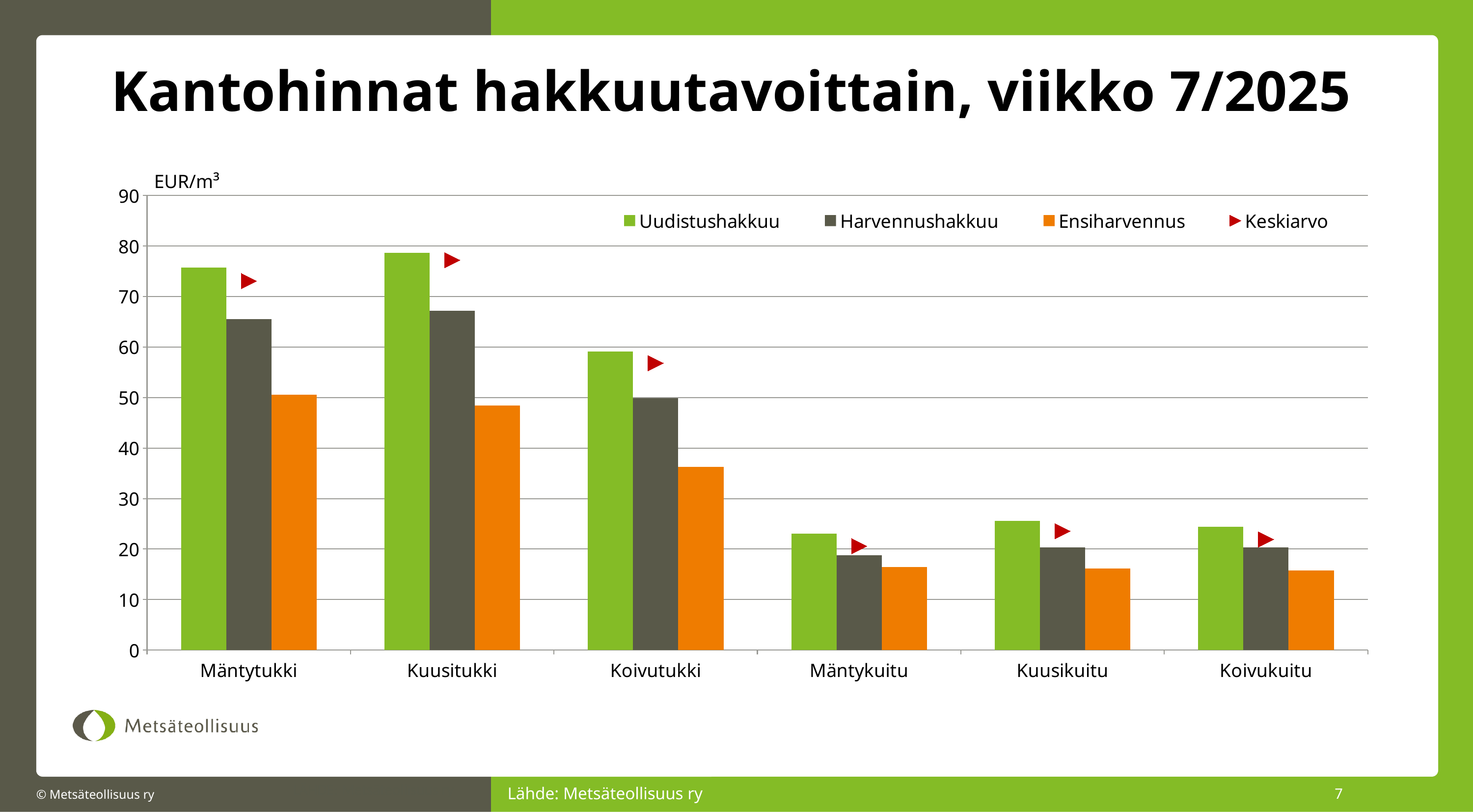
Which is larger: the Harvennushakkuu value for Mäntytukki or the Uudistushakkuu value for Koivutukki? Harvennushakkuu value for Mäntytukki What kind of chart is shown on the slide? bar chart How many series does the legend list? 4 Is the Ensiharvennus value for Koivutukki greater or less than 40? less What is the title of the chart? Kantohinnat hakkuutavoittain, viikko 7/2025 How many categories are shown on the x axis? 6 Is the Uudistushakkuu value for Mäntykuitu greater or less than 20? greater Is the Uudistushakkuu value for Mäntytukki greater or less than 70? greater What unit is shown on the y axis? EUR/m³ Which category has the highest Uudistushakkuu value? Kuusitukki Which is larger: the Uudistushakkuu value for Koivutukki or the Harvennushakkuu value for Kuusitukki? Harvennushakkuu value for Kuusitukki